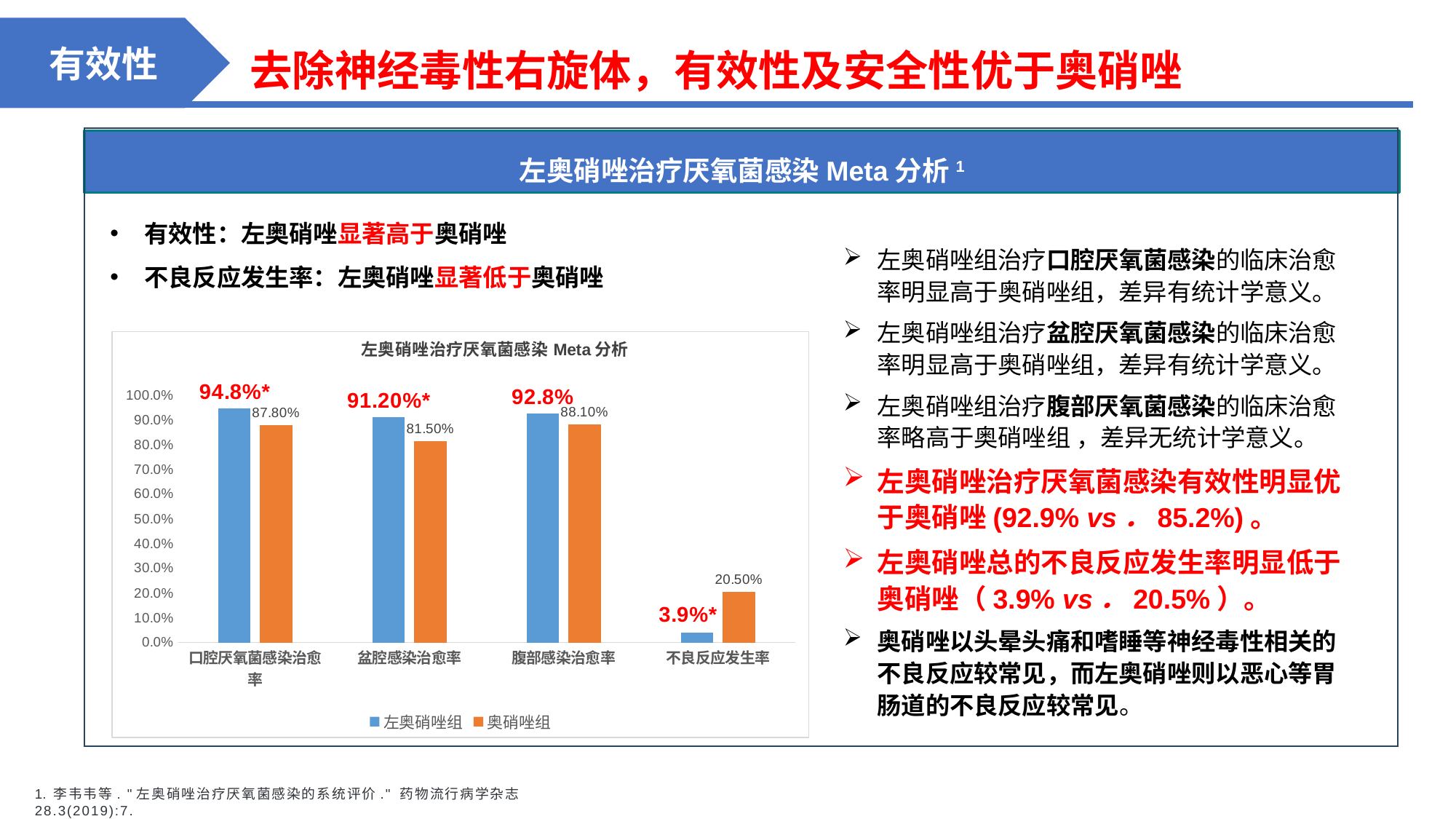
Which category has the lowest value for 左奥硝唑组? 不良反应发生率 What is the difference between 奥硝唑组 and 左奥硝唑组 in the 不良反应发生率 category? 16.6 percentage points What is the value for 左奥硝唑组 in the 口腔厌氧菌感染治愈率 category? 94.8% How many series does the chart legend list? 2 What type of chart is shown on the slide? Bar chart Which category has the highest value for 奥硝唑组? 腹部感染治愈率 What is the value for 奥硝唑组 in the 不良反应发生率 category? 20.50% What is the value for 左奥硝唑组 in the 腹部感染治愈率 category? 92.8% In the 腹部感染治愈率 category, which group has the larger value, 左奥硝唑组 or 奥硝唑组? 左奥硝唑组 How many categories are shown on the x axis of the chart? 4 What is the difference between 左奥硝唑组 and 奥硝唑组 in the 盆腔感染治愈率 category? 9.7 percentage points What is the value for 奥硝唑组 in the 盆腔感染治愈率 category? 81.50%